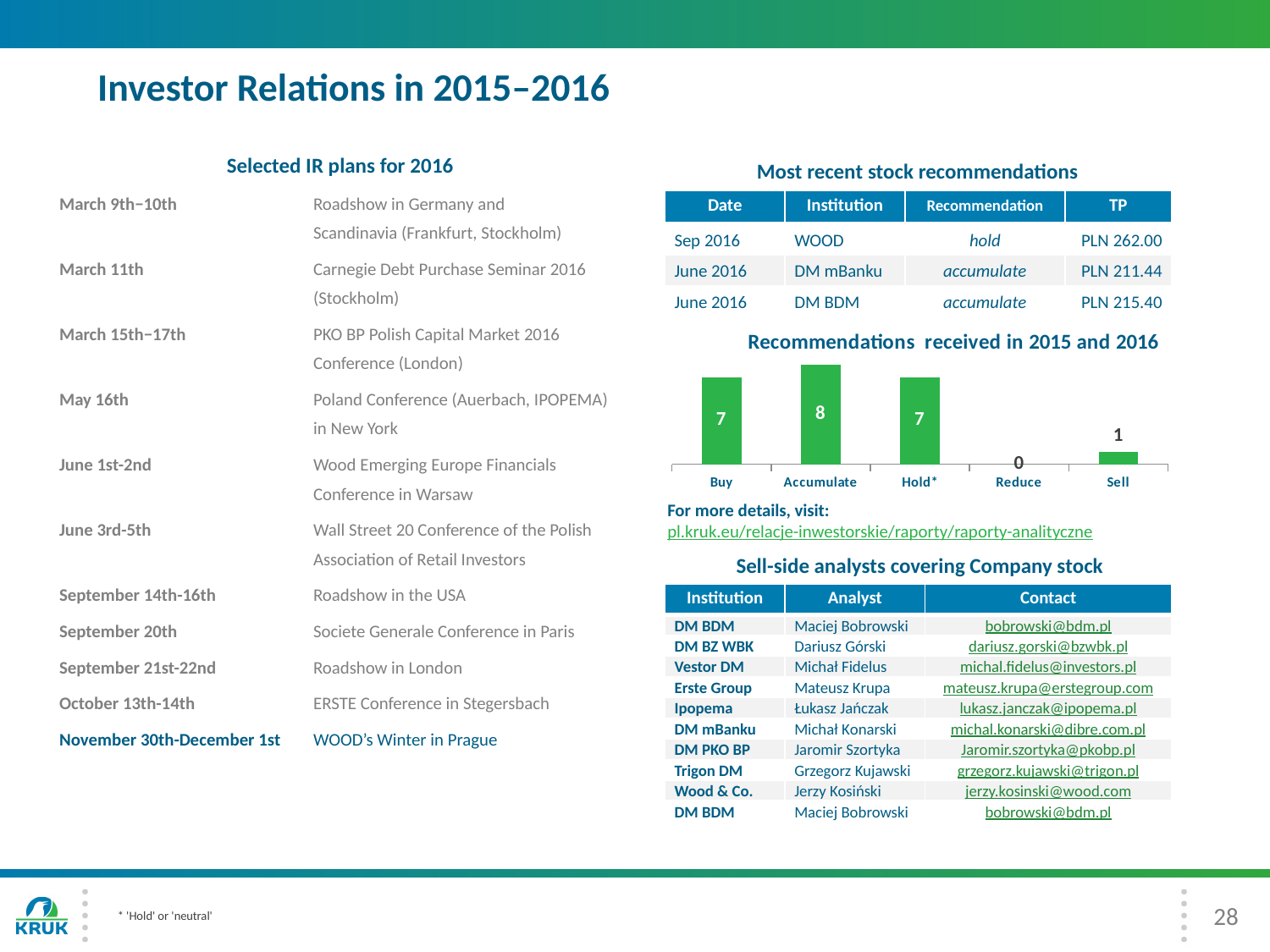
In the 'Recommendations received in 2015 and 2016' chart, what is the value for Sell? 1 In the 'Recommendations received in 2015 and 2016' chart, which recommendation category has the highest value? Accumulate In the 'Recommendations received in 2015 and 2016' chart, what is the value for Reduce? 0 In the 'Recommendations received in 2015 and 2016' chart, what is the value for Accumulate? 8 In the 'Recommendations received in 2015 and 2016' chart, what is the difference between the Accumulate and Sell values? 7 In the 'Recommendations received in 2015 and 2016' chart, what is the total of all recommendations shown? 23 In the 'Recommendations received in 2015 and 2016' chart, how many Buy recommendations are shown? 7 In the 'Recommendations received in 2015 and 2016' chart, which recommendation category has the lowest value? Reduce In the 'Recommendations received in 2015 and 2016' chart, which is larger, Buy or Sell? Buy How many recommendation categories are shown in the 'Recommendations received in 2015 and 2016' chart? 5 What type of chart is 'Recommendations received in 2015 and 2016'? Bar chart What is the title of the bar chart on the slide? Recommendations received in 2015 and 2016